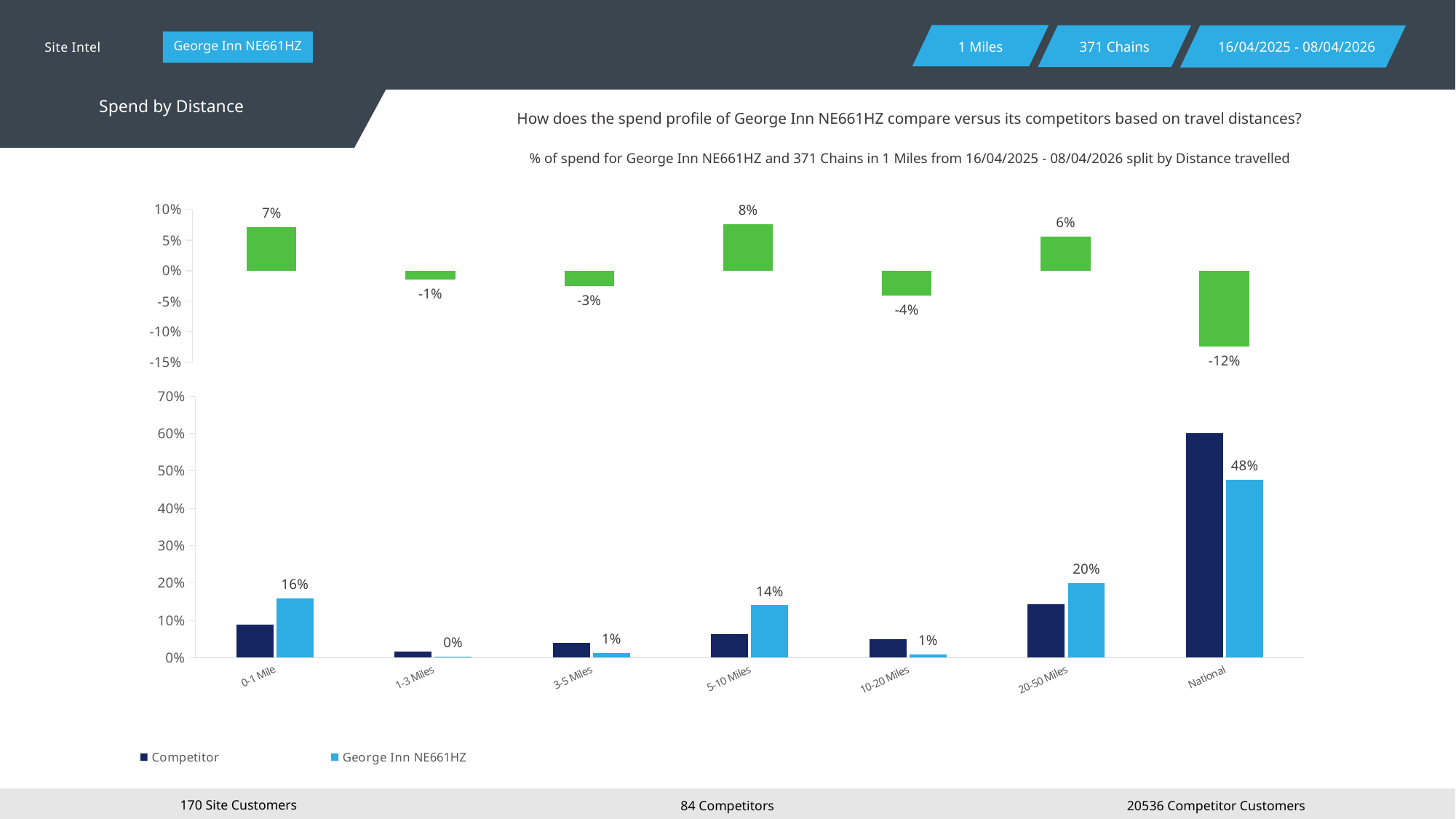
In the bottom chart, how many series does the legend list? 2 In the bottom chart, which is larger in the National category: Competitor or George Inn NE661HZ? Competitor In the bottom chart, how many distance categories are shown on the x axis? 7 In the bottom chart, what is the value for George Inn NE661HZ in the National category? 48% In the bottom chart, which category has the highest value for George Inn NE661HZ? National In the bottom chart, is the Competitor value for 20-50 Miles greater or less than 10%? greater In the top chart, what is the value for National? -12% In the bottom chart, is the Competitor value for National greater or less than 50%? greater In the top chart, which category has the highest value? 5-10 Miles In the bottom chart, what is the difference between the George Inn NE661HZ values for 20-50 Miles and 0-1 Mile? 4% In the top chart, what is the value for 5-10 Miles? 8% In the top chart, which category has the lowest value? National